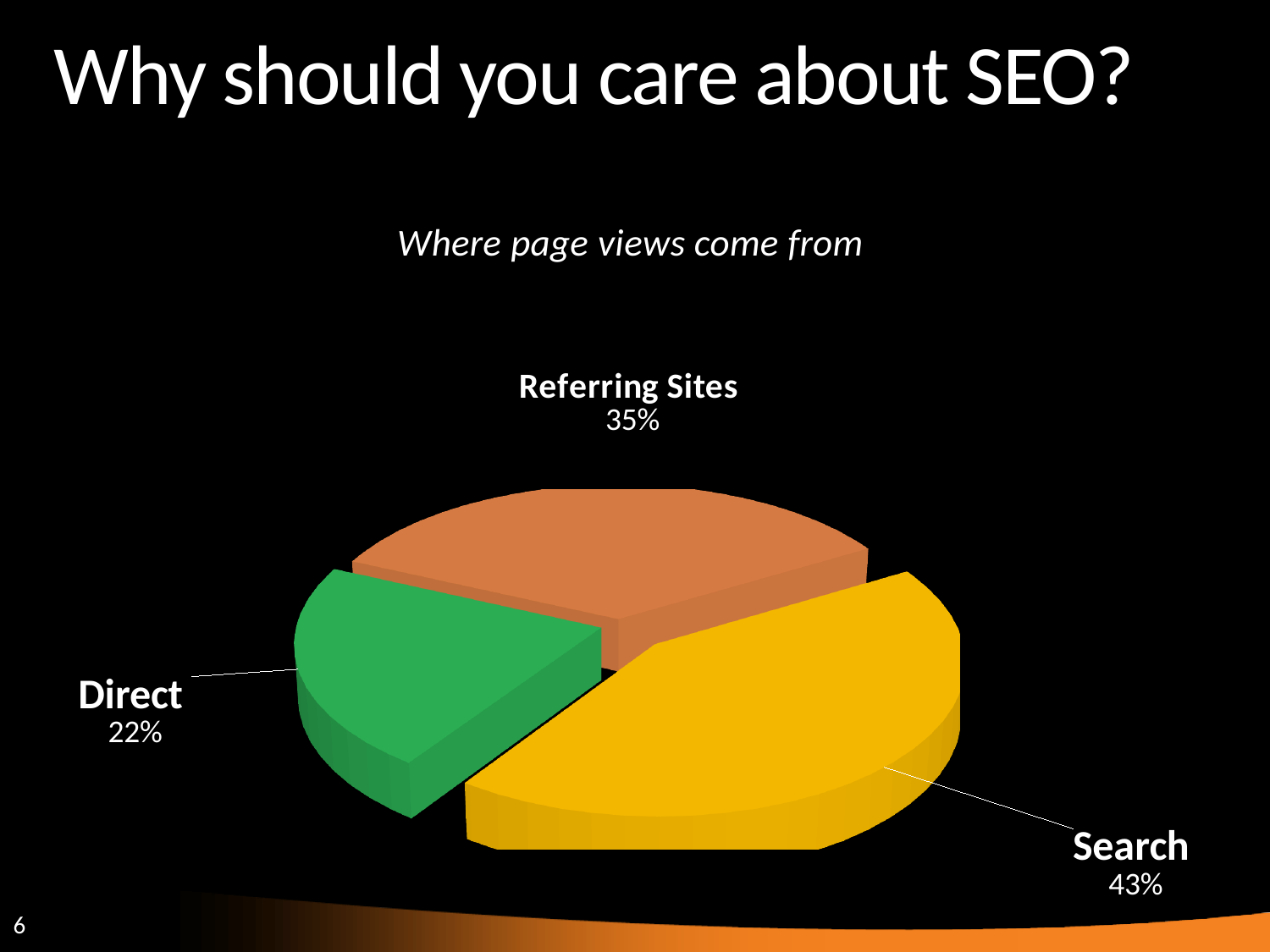
How many percentage points larger is the Search share than the Direct share? 21 percentage points How many slices does the pie chart have? 3 What share of page views comes from Search? 43% Which source accounts for the smallest share of page views? Direct What is the title of the chart? Where page views come from What kind of chart is shown on the slide? Pie chart Which source accounts for the largest share of page views? Search What share of page views comes from Referring Sites? 35% Which is larger, the share for Referring Sites or the share for Direct? Referring Sites What is the difference between the Search share and the Referring Sites share? 8 percentage points What share of page views comes from Direct? 22% What colour is the Search slice of the pie chart? Yellow